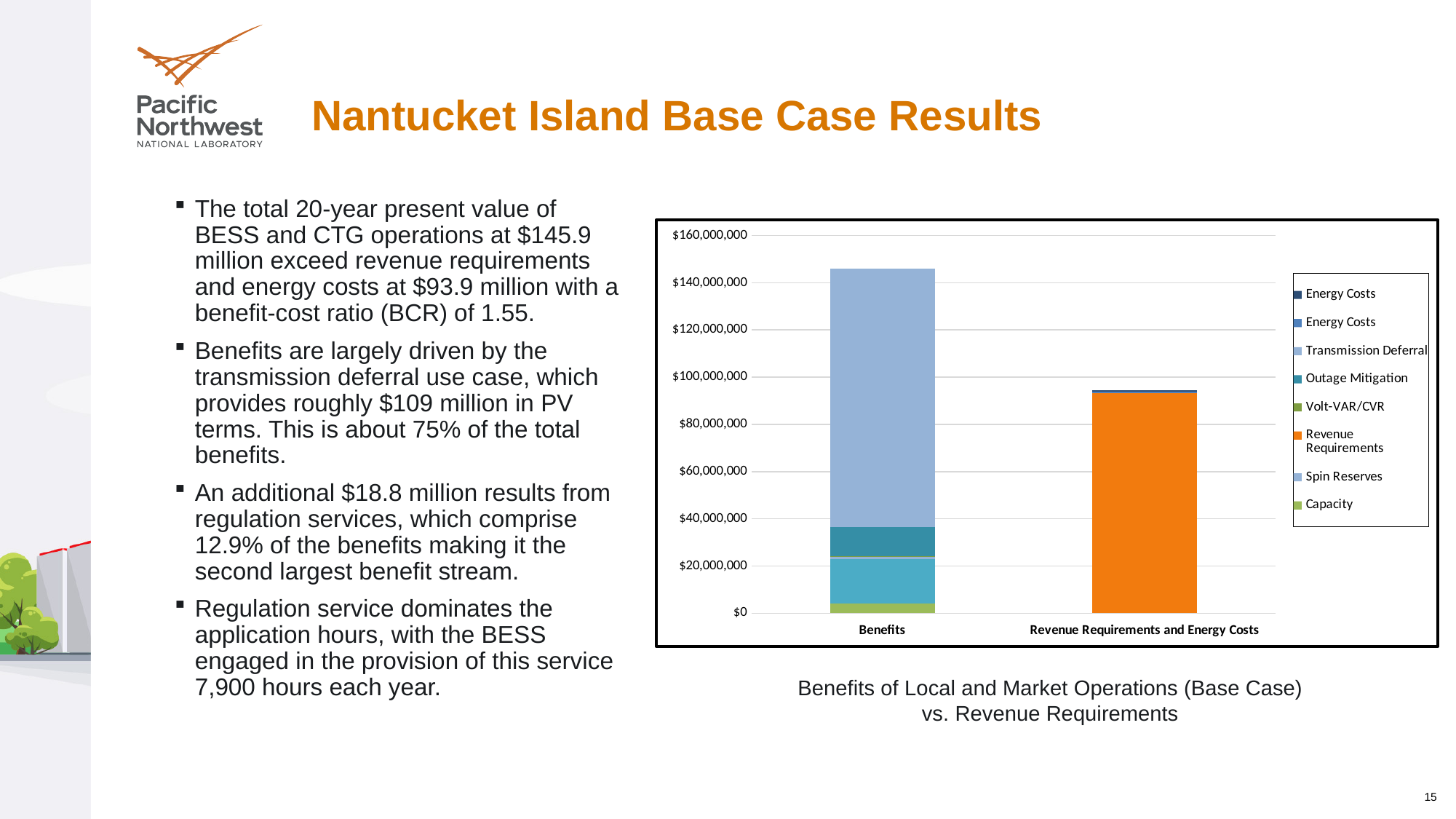
Which series makes up the largest segment of the Benefits bar? Transmission Deferral What colour represents Revenue Requirements in the chart? Orange What is the caption printed below the chart? Benefits of Local and Market Operations (Base Case) vs. Revenue Requirements Which bar is taller, Benefits or Revenue Requirements and Energy Costs? Benefits Is the total of the Revenue Requirements and Energy Costs bar greater or less than $80,000,000? greater Which category has the highest total bar? Benefits Is the total of the Revenue Requirements and Energy Costs bar greater or less than $100,000,000? less What kind of chart is shown on the slide? Stacked bar chart Is the total of the Benefits bar greater or less than $140,000,000? greater How many series does the chart's legend list? 8 How many categories are shown on the x axis of the chart? 2 Which category has the lowest total bar? Revenue Requirements and Energy Costs